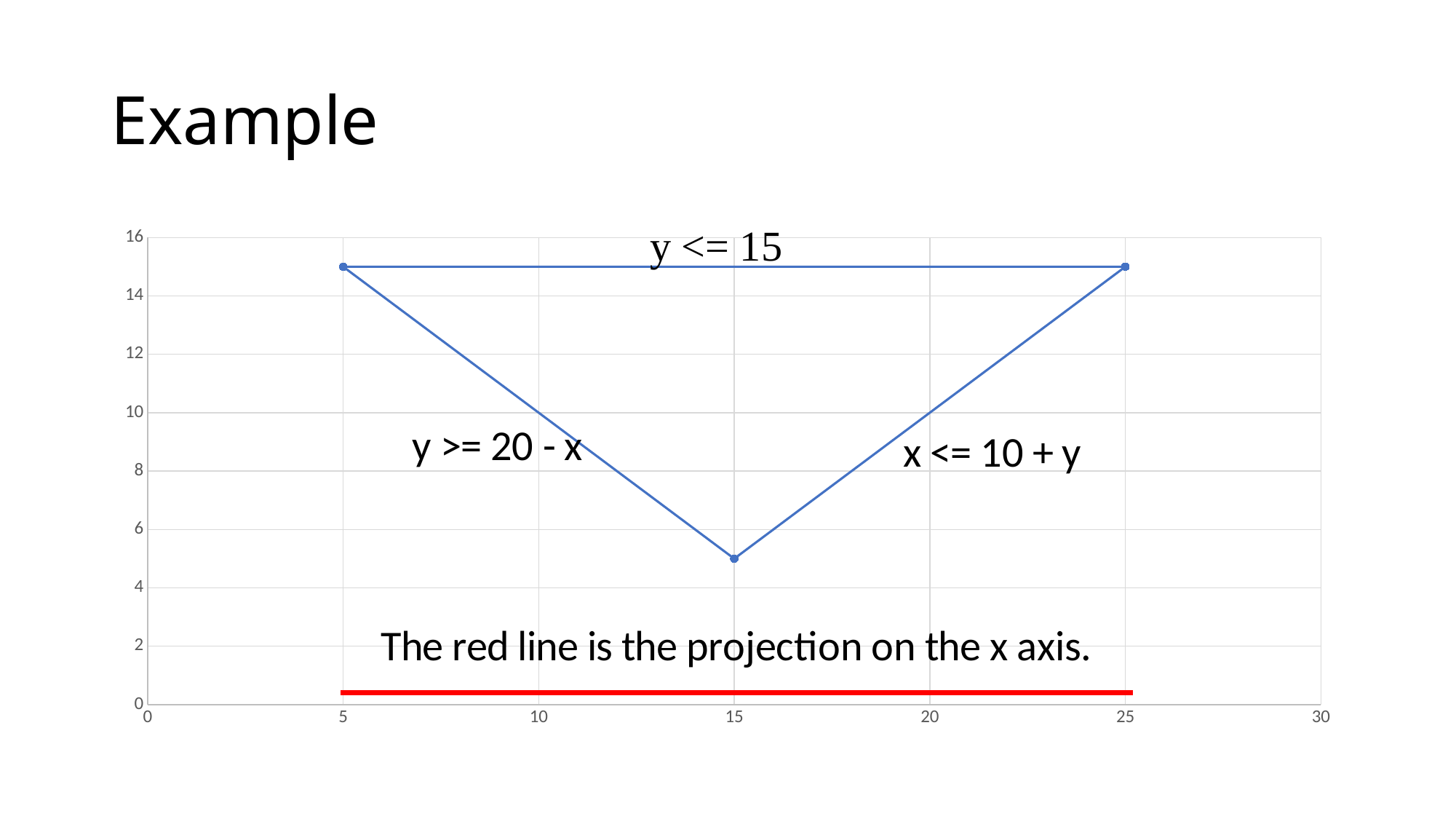
At what x value is the rightmost marked point of the blue line? 25 Is the y value of the point at x = 25 greater or less than 14? greater Is the y value at x = 5 larger or smaller than the y value at x = 15? larger How many data points are marked on the blue line? 3 Is the y value of the lowest point on the blue line greater or less than 6? less According to the text on the slide, what does the red line represent? The projection on the x axis What constraint label is written above the top edge of the triangle? y <= 15 At what x value is the leftmost marked point of the blue line? 5 Do the y values of the blue line rise or fall as x goes from 5 to 15? fall At what x value does the lowest point of the blue line occur? 15 Which marked point has the lowest y value: the one at x = 5, x = 15, or x = 25? x = 15 What kind of chart is shown on the slide? line chart